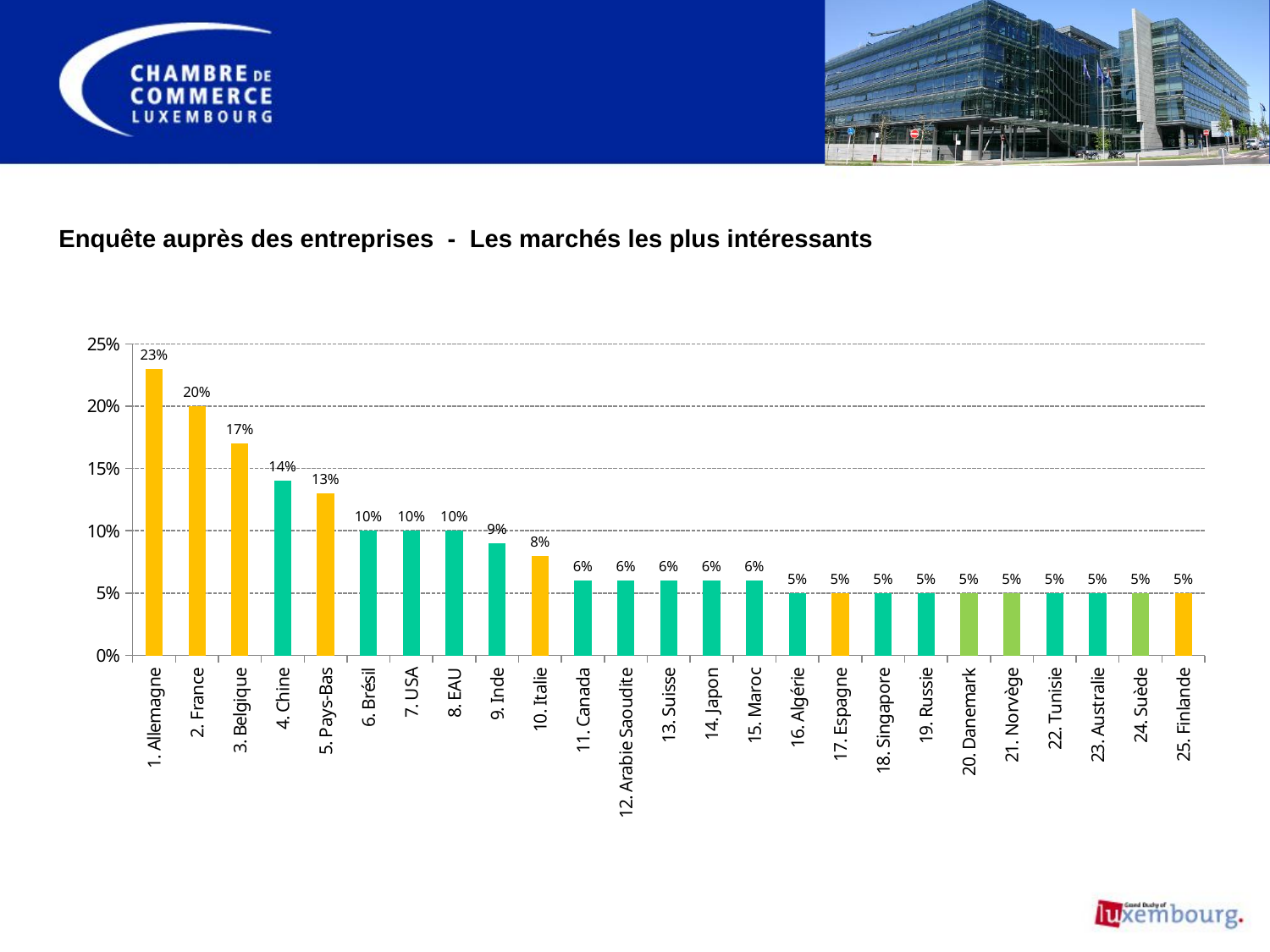
What kind of chart is shown on the slide? bar chart What is the value for 4. Chine? 14% What is the value for 10. Italie? 8% Do the values rise or fall from left to right along the x axis? fall Is the value for 3. Belgique greater or less than 15%? greater What is the value for 15. Maroc? 6% How many categories are shown on the x axis? 25 What is the difference between the values for 2. France and 3. Belgique? 3% Which is larger, the value for 5. Pays-Bas or the value for 9. Inde? 5. Pays-Bas What is the title of the slide containing the chart? Enquête auprès des entreprises - Les marchés les plus intéressants What is the value for 1. Allemagne? 23% Which category has the highest value? 1. Allemagne